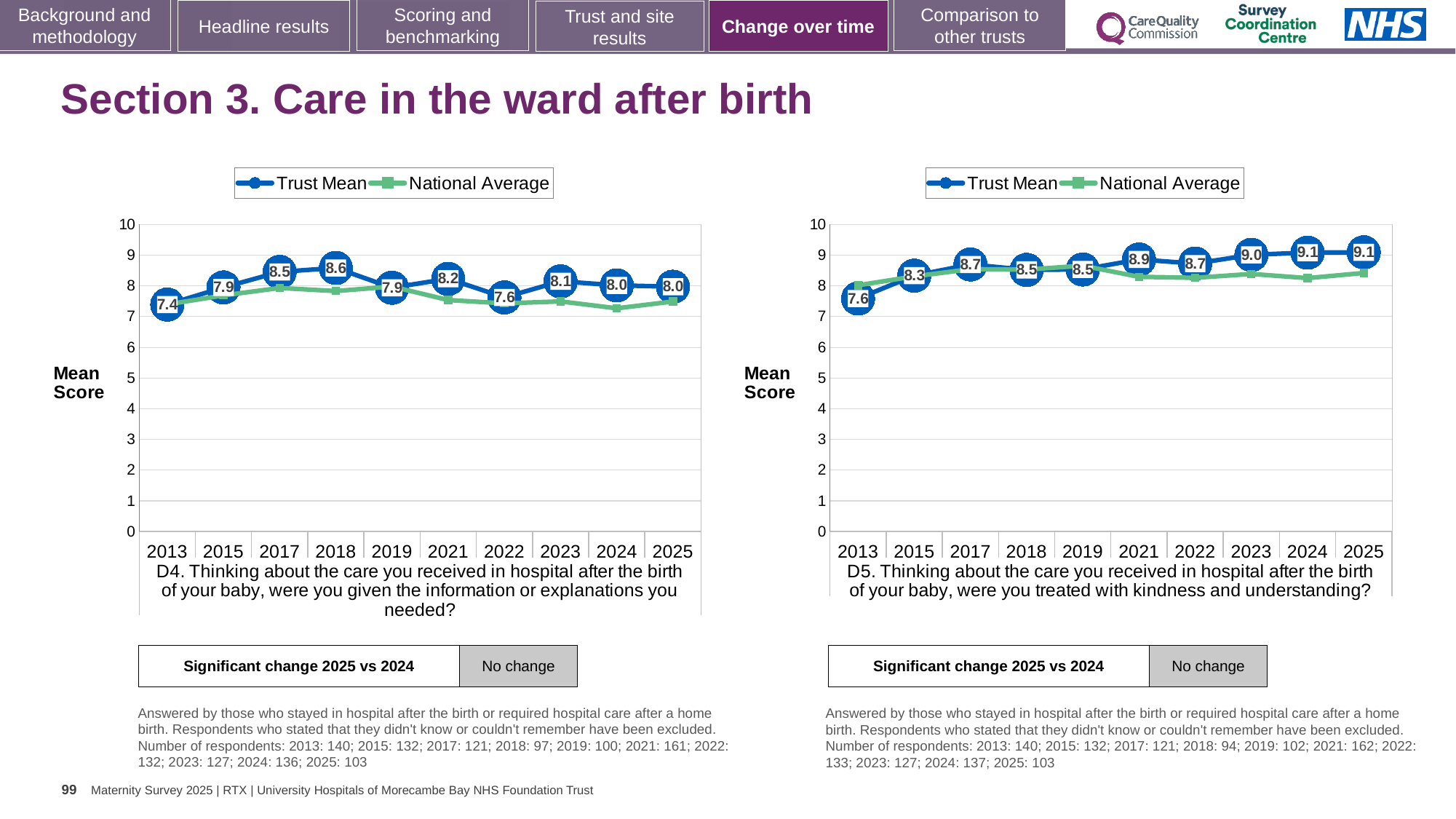
How many years are shown on the x axis of the D4 chart on the left? 10 In the D5 chart on the right, what is the Trust Mean score for 2025? 9.1 In the D5 chart on the right, which year has the lowest Trust Mean score? 2013 In the D4 chart on the left, what is the Trust Mean score for 2018? 8.6 In the D4 chart on the left, what is the difference between the Trust Mean scores for 2018 and 2013? 1.2 In the D4 chart on the left, is the Trust Mean score higher in 2017 or in 2022? 2017 In the D5 chart on the right, what is the difference between the Trust Mean scores for 2025 and 2013? 1.5 In the D5 chart on the right, is the National Average for 2025 greater or less than 8? greater What type of chart is the D4 chart on the left? Line chart In the D4 chart on the left, which year has the highest Trust Mean score? 2018 How many series does the legend of the D5 chart on the right list? 2 What does the 'Significant change 2025 vs 2024' box below the D5 chart on the right say? No change